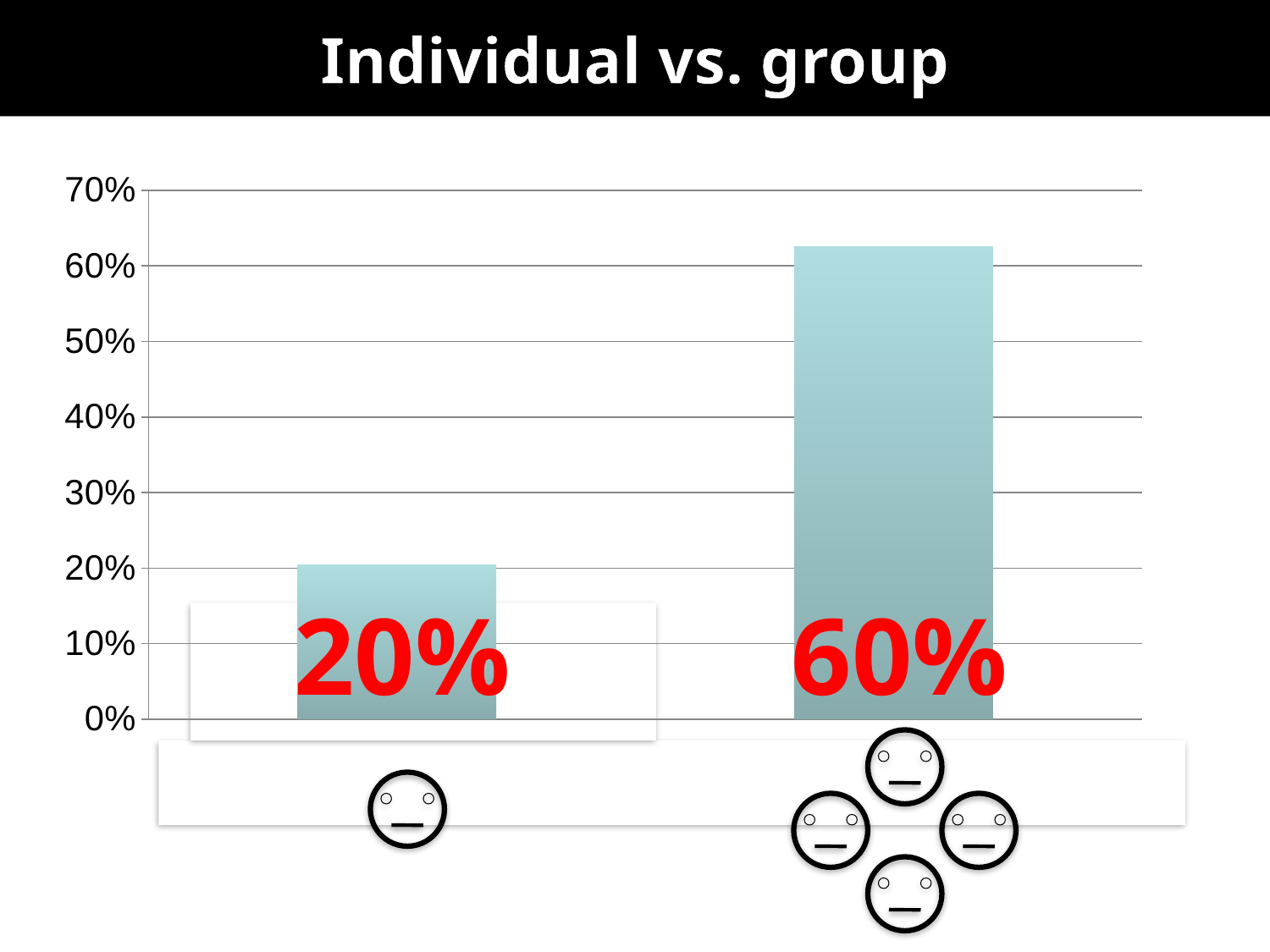
Which bar is lower, the individual bar or the group bar? individual Which bar is higher, the individual bar or the group bar? group How many bars are plotted in the chart? 2 What is the difference between the printed values for the group bar and the individual bar? 40% What value is printed on the right bar (the group, four-face category)? 60% Do the bar values rise or fall from left to right? rise What is the title of the slide? Individual vs. group What kind of chart is shown on the slide? bar chart Is the value for the group bar greater or less than 50%? greater Is the value for the individual bar greater or less than 30%? less What is the highest value shown on the vertical axis? 70% What value is printed on the left bar (the individual, single-face category)? 20%